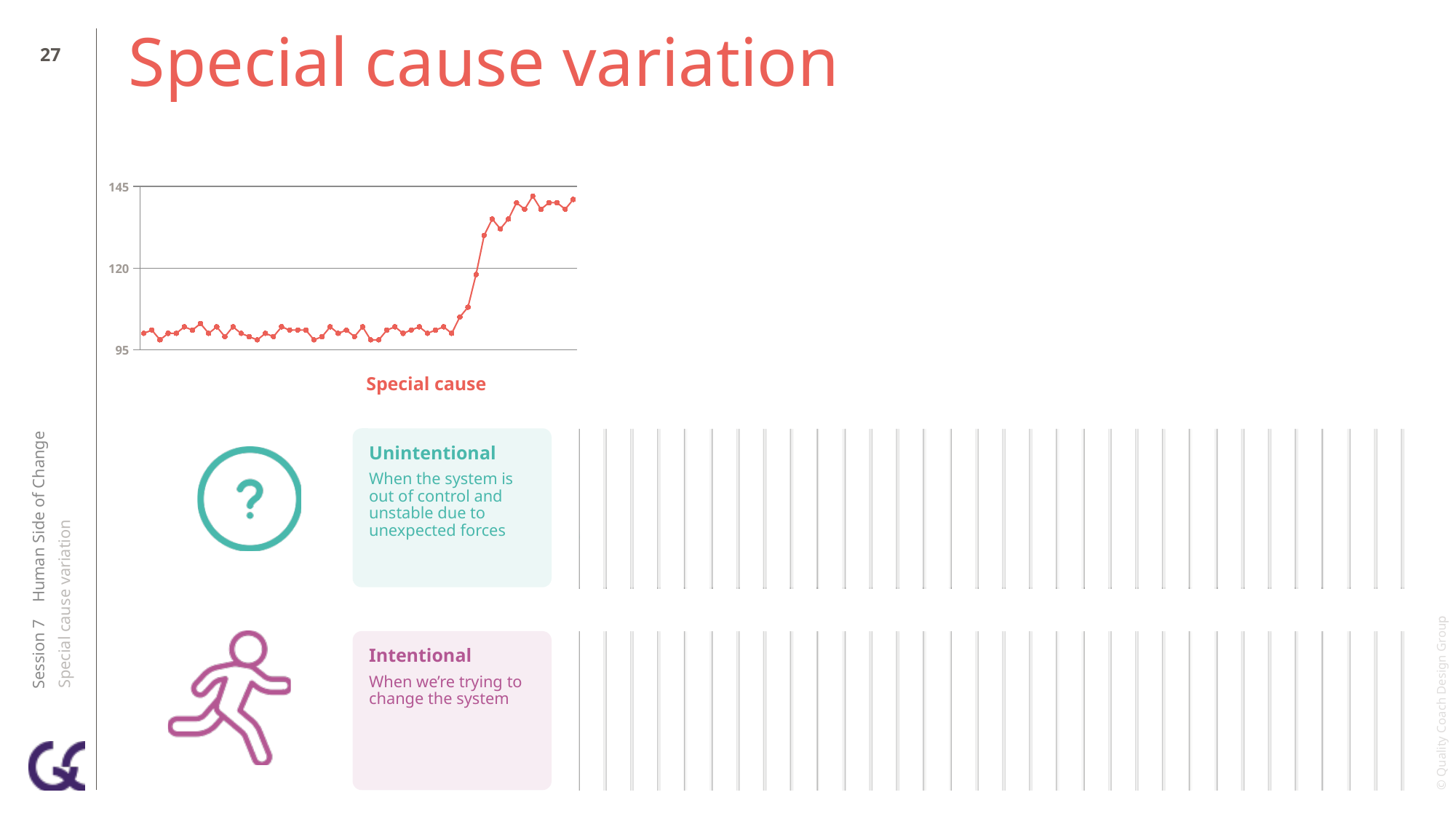
Is the value of the last point on the line greater or less than 120? greater What is the title shown beneath the chart? Special cause Do the plotted values rise or fall along the x axis overall? rise Which is larger, the value of the first point or the value of the last point on the line? the last point What is the highest value labelled on the y axis? 145 Is the value of the first point on the line greater or less than 120? less What kind of chart is shown on the slide? line chart Is the value of the last point on the line greater or less than 145? less Does the line shift to a higher level or a lower level in the right-hand part of the chart? higher